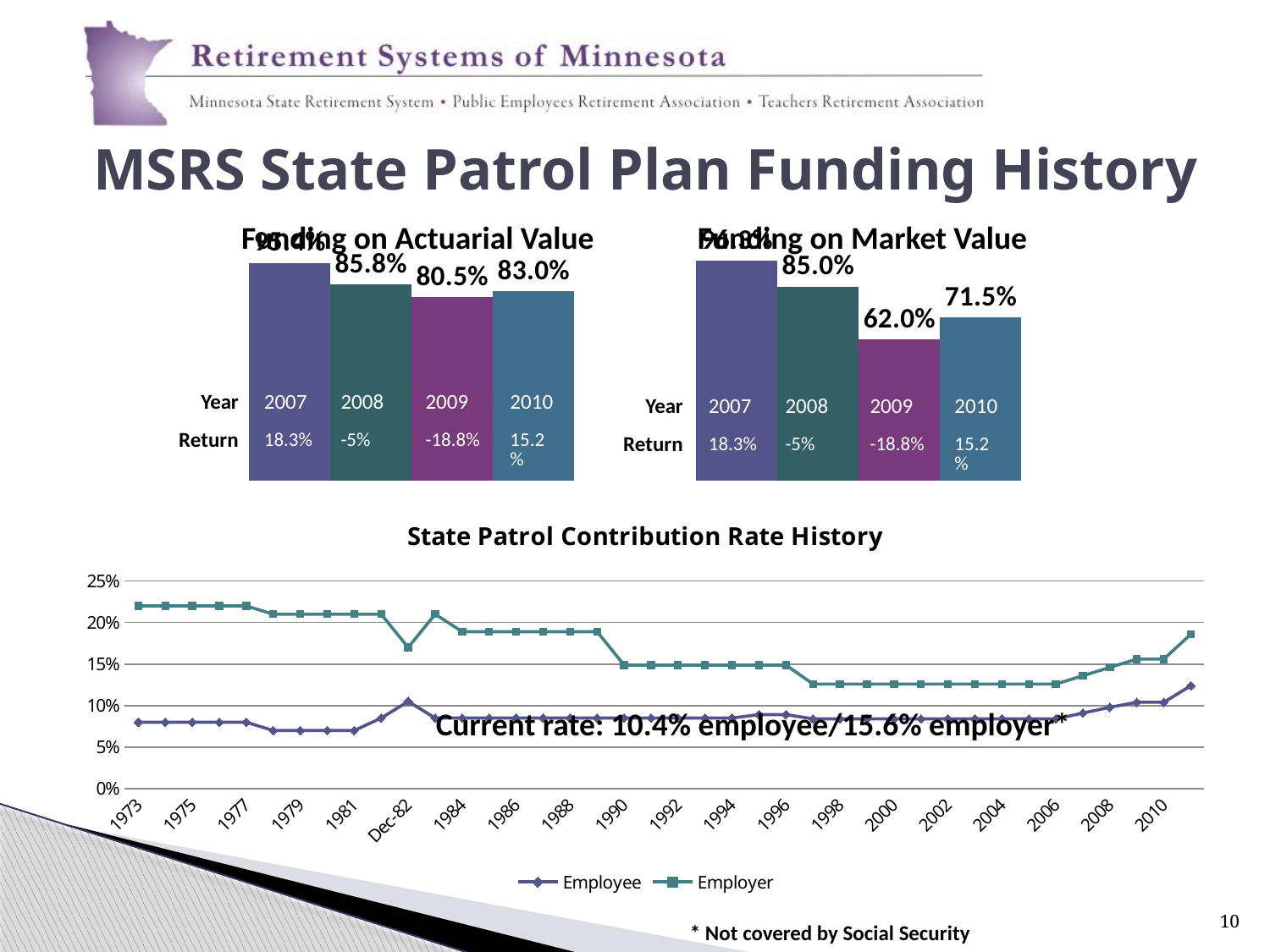
How many series does the legend of the State Patrol Contribution Rate History chart list? 2 In the State Patrol Contribution Rate History chart, is the Employer rate in 1973 greater or less than 20%? greater In the Funding on Actuarial Value chart, which year has the lowest funding value? 2009 In the Funding on Market Value chart, what investment return is shown for 2009? -18.8% In the Funding on Market Value chart, what is the difference between the 2010 and 2009 funding values? 9.5% In the Funding on Market Value chart, which year has the highest funding value? 2007 In the Funding on Actuarial Value chart, which is larger, the value for 2008 or the value for 2009? 2008 In the Funding on Actuarial Value chart, what is the funding value for 2008? 85.8% In the Funding on Market Value chart, what is the funding value for 2010? 71.5% In the Funding on Actuarial Value chart, what is the funding value for 2010? 83.0% What kind of chart is the State Patrol Contribution Rate History chart? line chart In the Funding on Market Value chart, what is the funding value for 2009? 62.0%